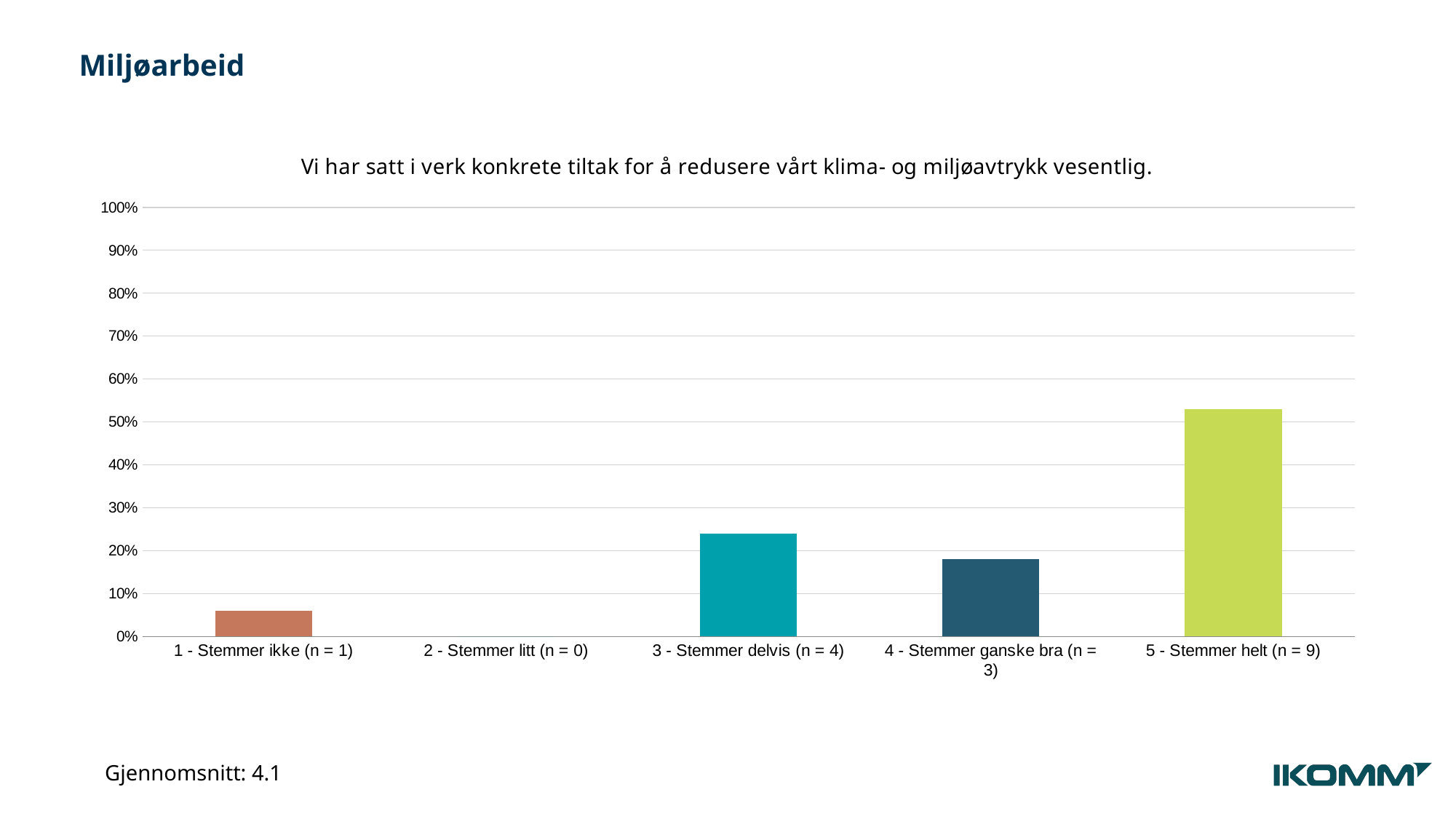
Is the value for '5 - Stemmer helt (n = 9)' greater or less than 50%? greater Is the value for '1 - Stemmer ikke (n = 1)' greater or less than 10%? less What kind of chart is shown on the slide? bar chart Is the value for '3 - Stemmer delvis (n = 4)' greater or less than 30%? less Which category has the lowest value in the chart? 2 - Stemmer litt (n = 0) What average (Gjennomsnitt) is stated below the chart? 4.1 Which is larger, the value for '3 - Stemmer delvis (n = 4)' or the value for '4 - Stemmer ganske bra (n = 3)'? 3 - Stemmer delvis (n = 4) Which category has the highest value in the chart? 5 - Stemmer helt (n = 9) What is the title of the chart? Vi har satt i verk konkrete tiltak for å redusere vårt klima- og miljøavtrykk vesentlig. What is the value for '2 - Stemmer litt (n = 0)'? 0% How many categories are shown on the x axis of the chart? 5